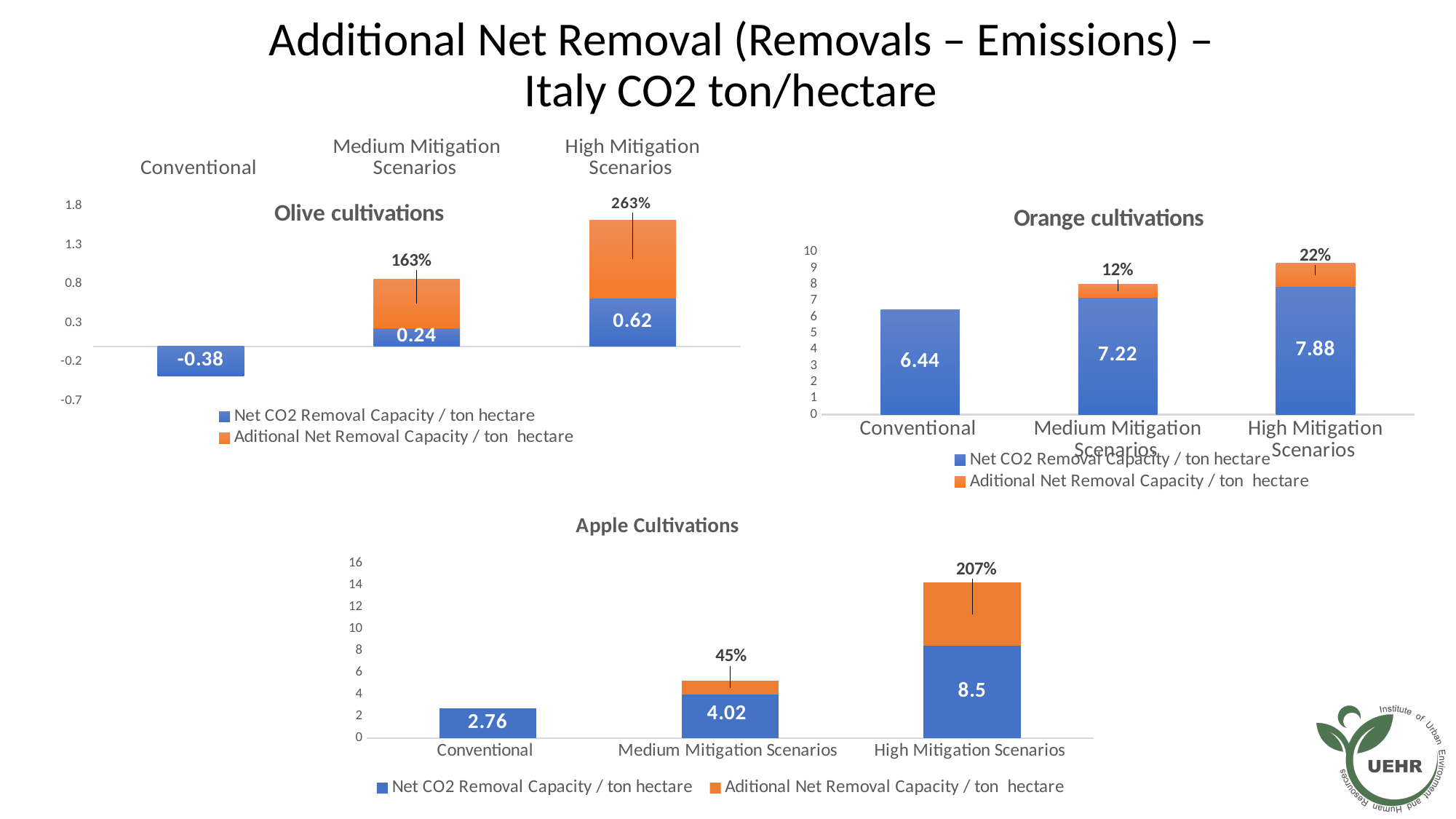
How many series does the legend of the Orange cultivations chart list? 2 In the Orange cultivations chart, what is the difference in Net CO2 Removal Capacity between High Mitigation Scenarios and Conventional? 1.44 In the Olive cultivations chart, what is the Net CO2 Removal Capacity value for Conventional? -0.38 In the Apple Cultivations chart, is the total height of the High Mitigation Scenarios bar greater or less than 12? greater In the Apple Cultivations chart, what percentage label is shown above the High Mitigation Scenarios bar? 207% In the Apple Cultivations chart, which is larger: the Net CO2 Removal Capacity for Medium Mitigation Scenarios or for Conventional? Medium Mitigation Scenarios What kind of chart is the Apple Cultivations chart? Stacked bar chart In the Olive cultivations chart, what percentage label is shown above the Medium Mitigation Scenarios bar? 163% In the Orange cultivations chart, what is the Net CO2 Removal Capacity value for Medium Mitigation Scenarios? 7.22 In the Apple Cultivations chart, what is the Net CO2 Removal Capacity value for Conventional? 2.76 In the Orange cultivations chart, which category has the highest Net CO2 Removal Capacity? High Mitigation Scenarios In the Olive cultivations chart, what is the Net CO2 Removal Capacity value for High Mitigation Scenarios? 0.62